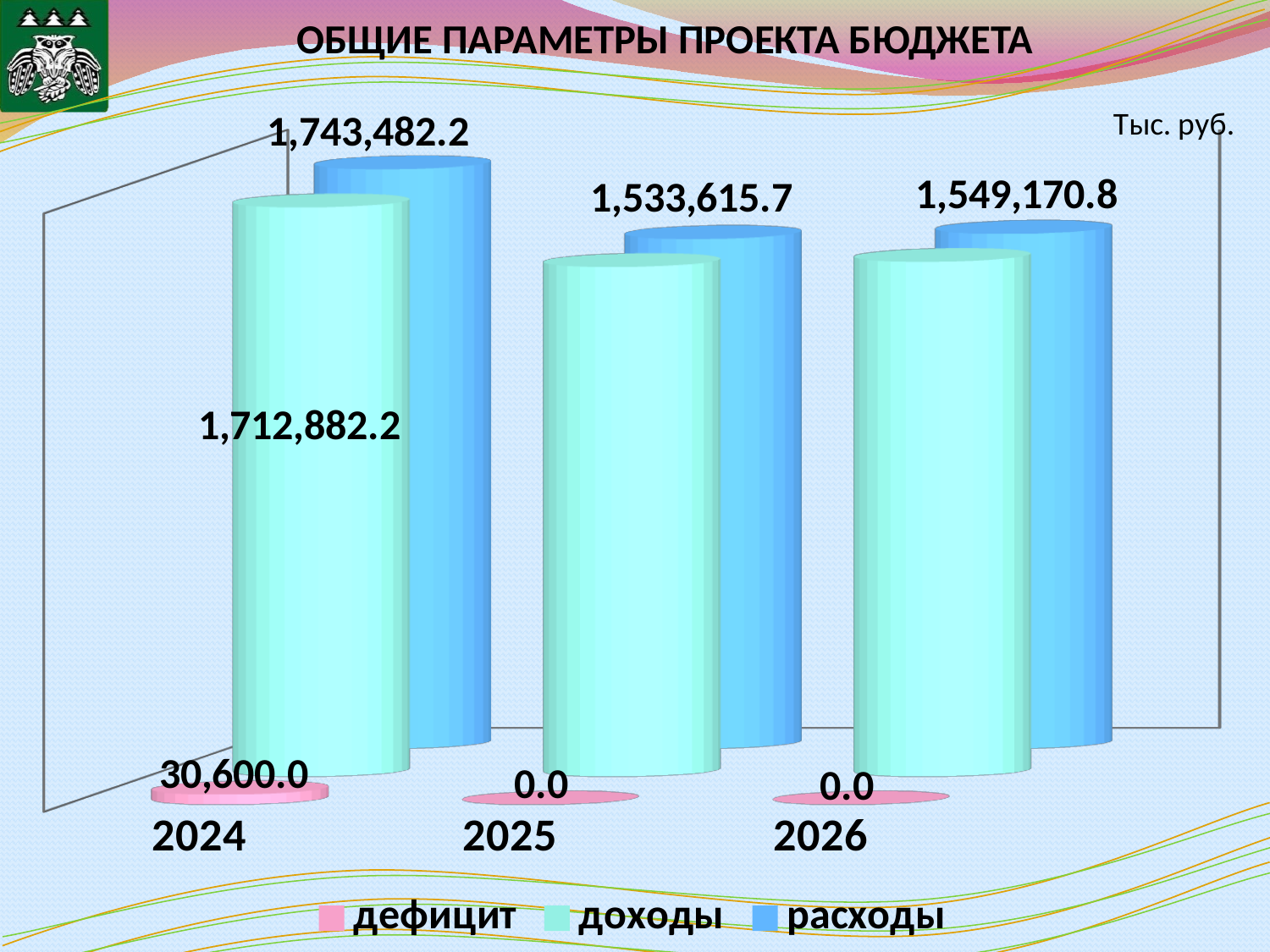
What is the value of дефицит for 2024? 30,600.0 What unit is indicated in the top right corner of the chart? Тыс. руб. What is the difference between расходы and доходы for 2024? 30,600.0 What is the value of расходы for 2026? 1,549,170.8 What is the value of расходы for 2024? 1,743,482.2 What is the value of дефицит for 2025? 0.0 What is the value of доходы for 2024? 1,712,882.2 How many years are shown on the x axis? 3 How many series does the legend list? 3 Which is larger for 2024, доходы or расходы? расходы Which year has the highest дефицит? 2024 What kind of chart is shown on the slide? bar chart